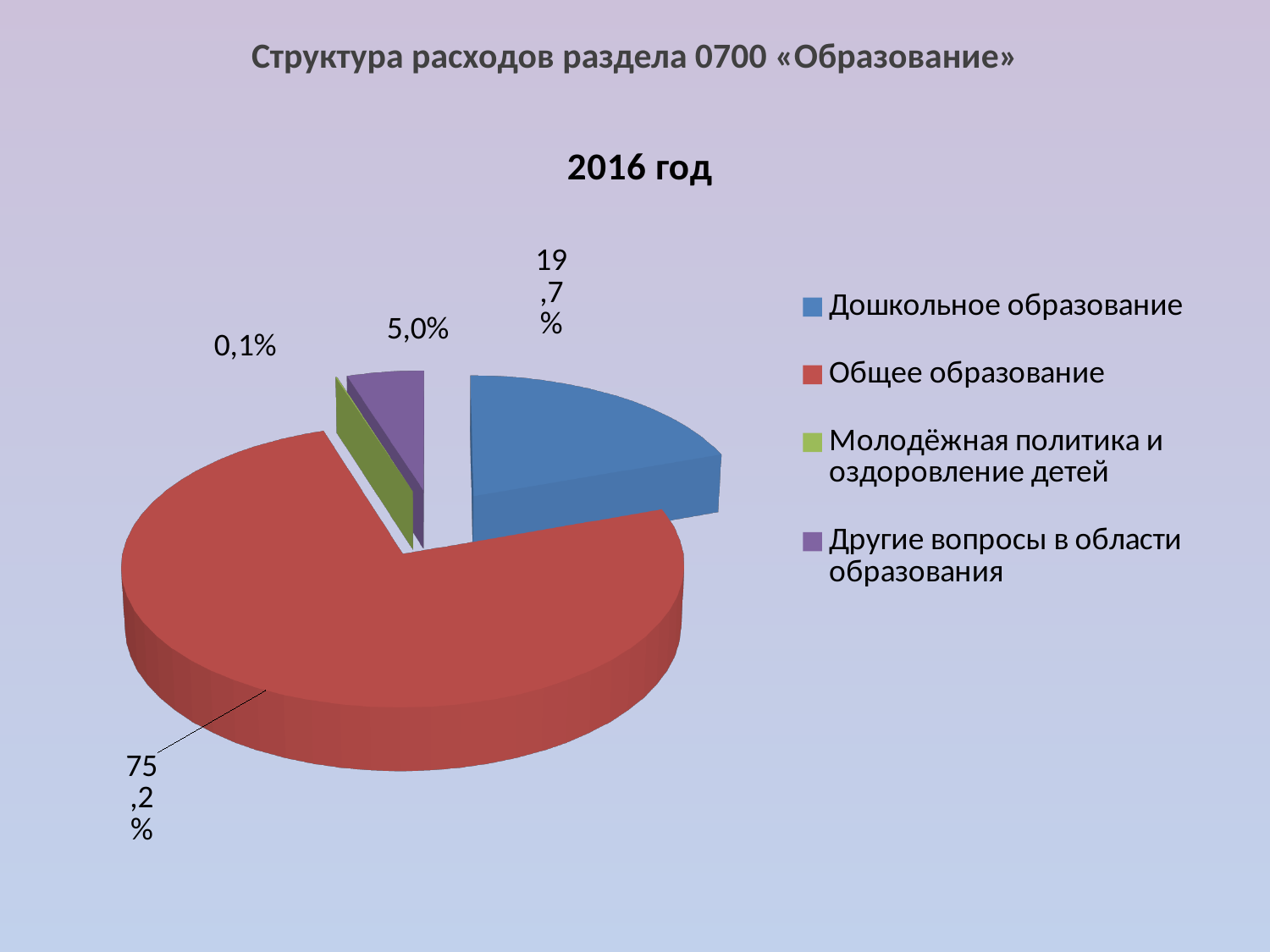
How many categories does the legend list? 4 What is the difference between the shares of Общее образование and Дошкольное образование? 55,5% Which category has the smallest share of the pie? Молодёжная политика и оздоровление детей What share of the pie is Молодёжная политика и оздоровление детей? 0,1% Which category has the largest share of the pie? Общее образование What kind of chart is shown on the slide? pie chart What share of the pie is Дошкольное образование? 19,7% What is the chart's title? 2016 год Which colour represents Общее образование in the chart? red What share of the pie is Общее образование? 75,2% Which is larger: the share for Дошкольное образование or the share for Другие вопросы в области образования? Дошкольное образование